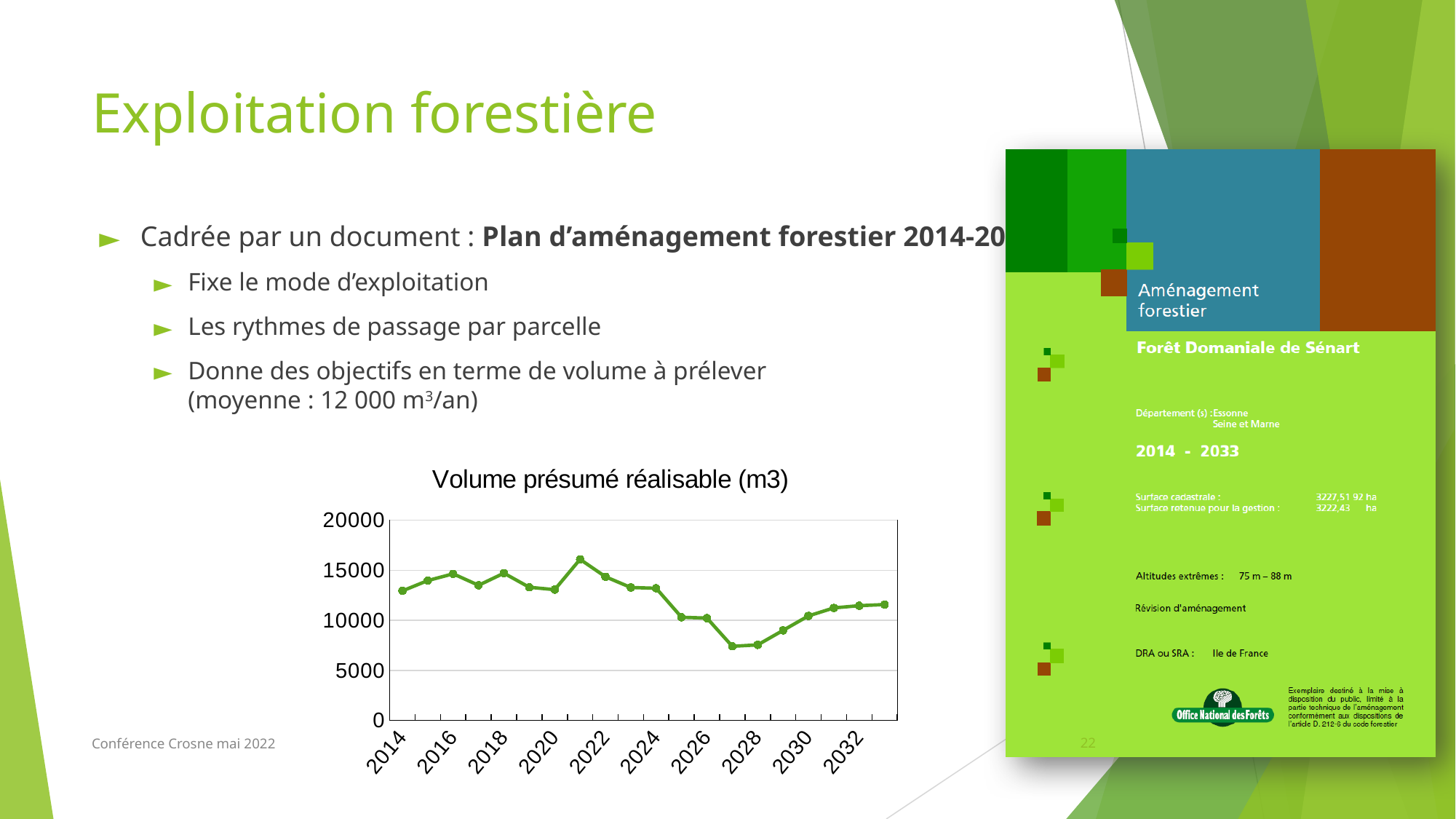
Is the value for 2014 greater or less than 10000? greater Is the value for 2021 greater or less than 15000? greater Do the values rise or fall between 2021 and 2027? fall Which year has the highest value in the chart? 2021 Which year has the larger value, 2018 or 2028? 2018 What kind of chart is shown on the slide? line chart Do the values rise or fall between 2028 and 2033? rise Is the value for 2032 greater or less than 10000? greater What is the title of the chart? Volume présumé réalisable (m3) Which year has the larger value, 2021 or 2027? 2021